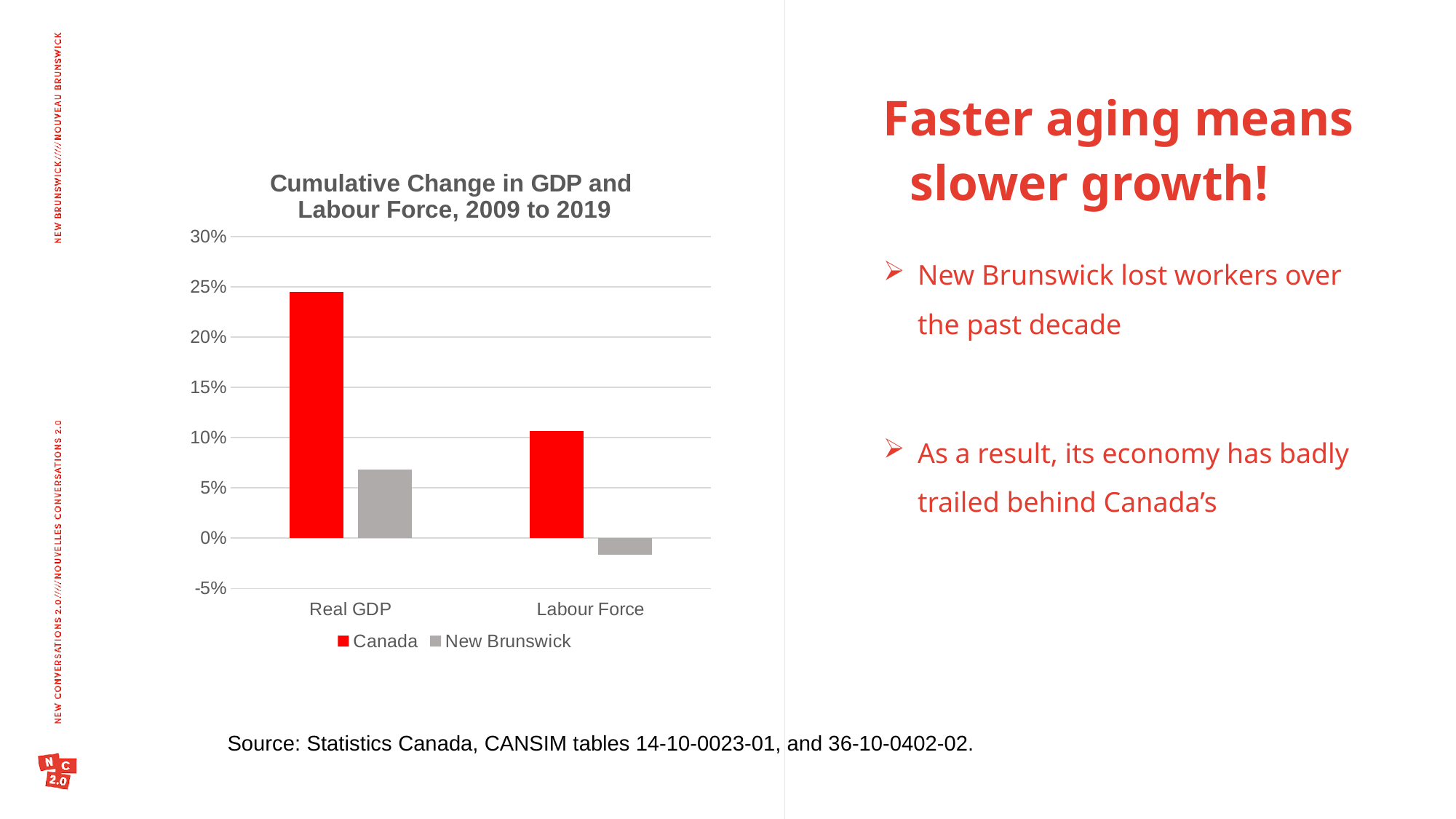
What kind of chart is shown on the slide? bar chart How many series does the chart's legend list? 2 What is the title of the chart? Cumulative Change in GDP and Labour Force, 2009 to 2019 Which bar in the chart is the highest? Canada, Real GDP For Labour Force, which is larger: the value for Canada or the value for New Brunswick? Canada Is the value for New Brunswick's Real GDP greater or less than 10%? less Is the value for Canada's Real GDP greater or less than 20%? greater Which bar in the chart is the lowest? New Brunswick, Labour Force Is the value for New Brunswick's Labour Force greater or less than 0%? less Which series is shown in red in the chart? Canada How many categories are shown on the x axis of the chart? 2